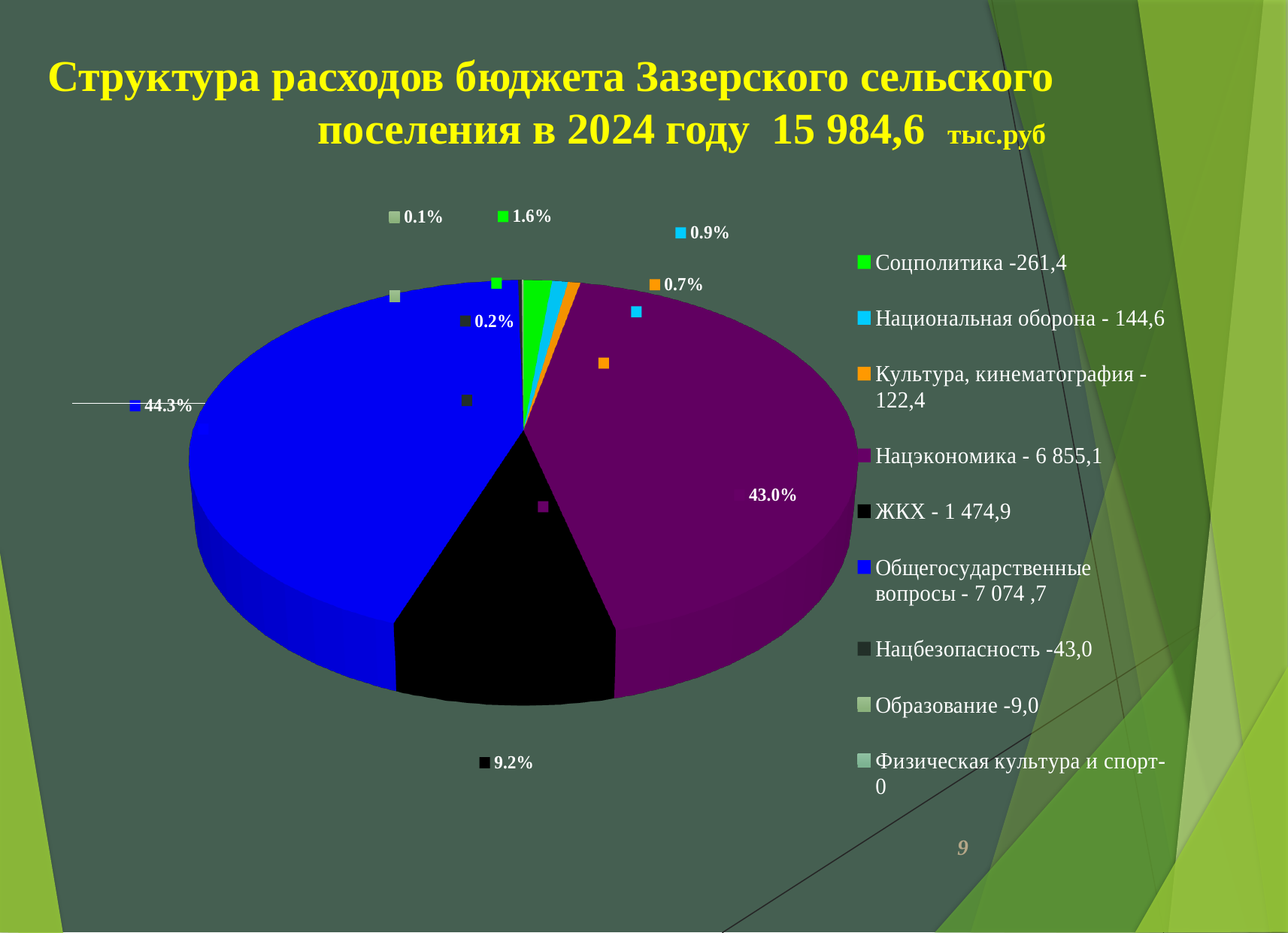
What kind of chart is shown on the slide? pie chart Which category has the largest slice of the pie? Общегосударственные вопросы What share of the pie does Соцполитика take? 1.6% What share of the pie does Нацэкономика take? 43.0% What total amount in тыс.руб is stated in the chart title? 15 984,6 What share of the pie does Общегосударственные вопросы take? 44.3% How many categories does the legend list? 9 What value does the legend give for Национальная оборона? 144,6 What value does the legend give for Нацэкономика? 6 855,1 What is the difference in percentage points between the shares of Общегосударственные вопросы and Нацэкономика? 1.3% Which of the two is larger: the share for ЖКХ or the share for Соцполитика? ЖКХ